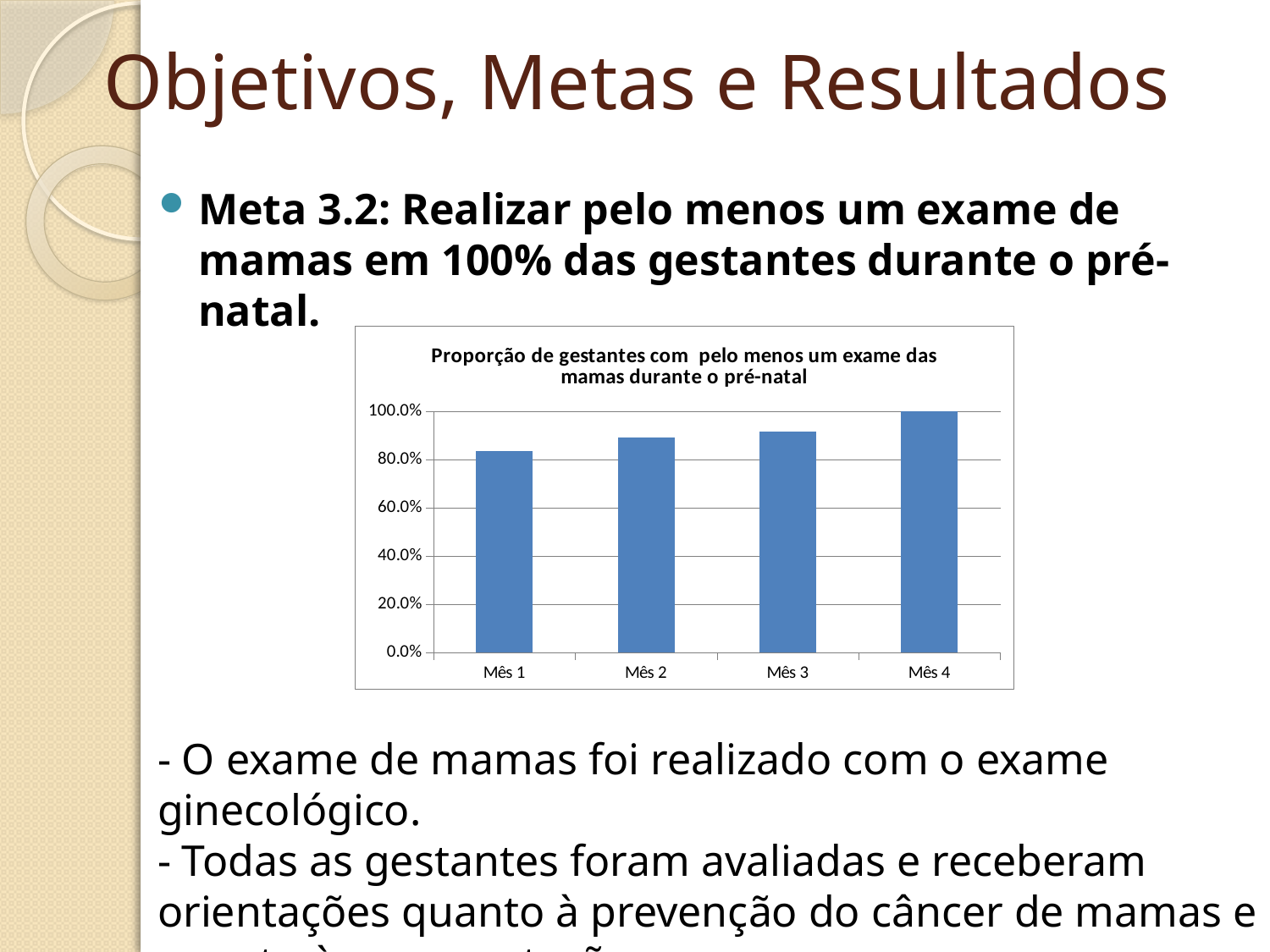
What kind of chart is shown on the slide? bar chart How many months (categories) are plotted on the x axis of the chart? 4 What is the title of the chart? Proporção de gestantes com pelo menos um exame das mamas durante o pré-natal Is the value for Mês 2 greater or less than 100.0%? less Which is larger, the value for Mês 1 or the value for Mês 4? Mês 4 Do the values rise or fall from Mês 1 to Mês 4? rise Which month has the lowest proportion in the chart? Mês 1 Which month has the highest proportion in the chart? Mês 4 What is the value for Mês 4 in the chart? 100.0% Is the value for Mês 1 greater or less than 80.0%? greater Which is larger, the value for Mês 1 or the value for Mês 3? Mês 3 Is the value for Mês 3 greater or less than 80.0%? greater